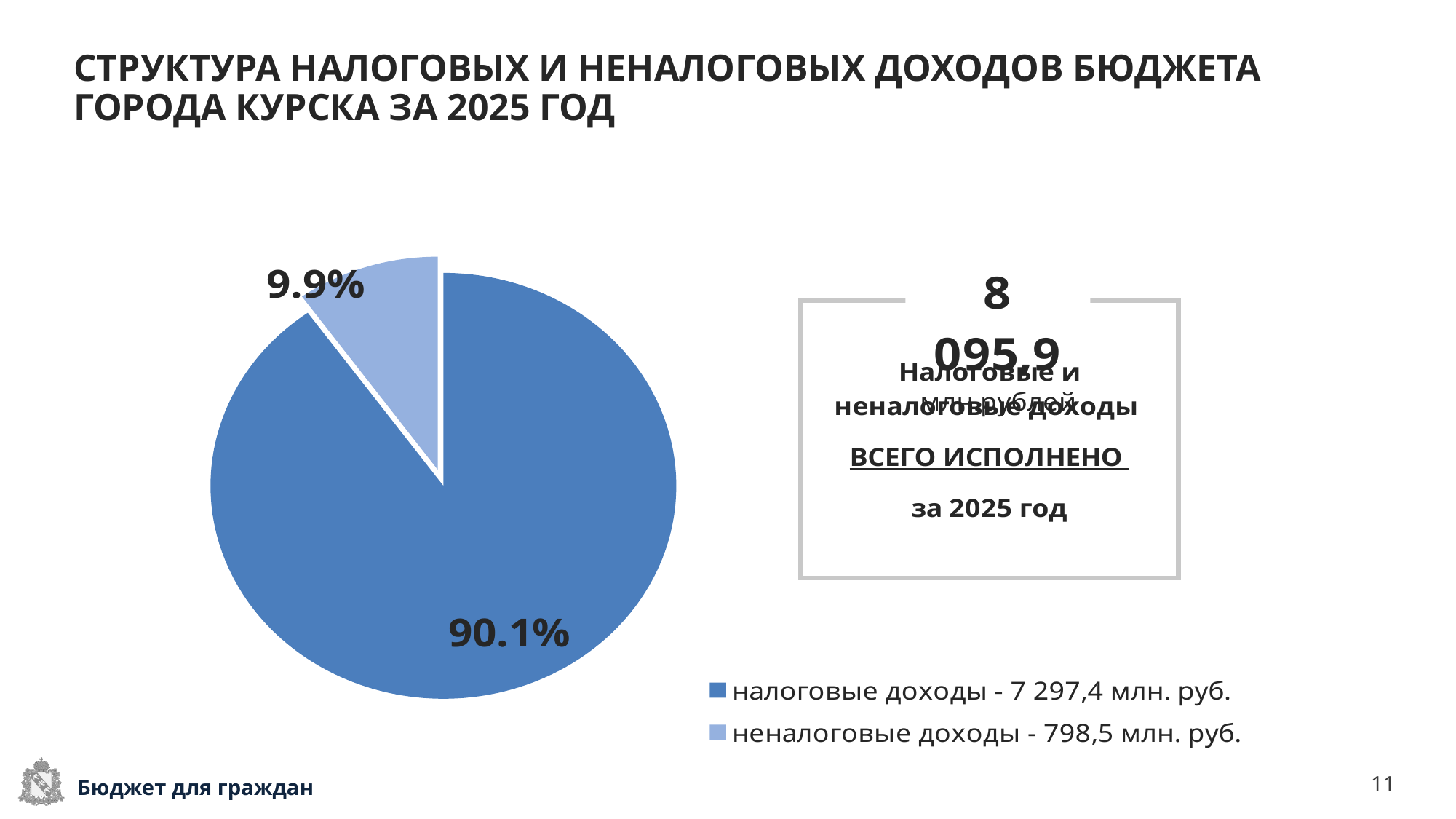
What is the difference in percentage points between the налоговые доходы slice and the неналоговые доходы slice? 80.2 Which is larger, налоговые доходы or неналоговые доходы? налоговые доходы According to the legend, what is the amount of налоговые доходы? 7 297,4 млн. руб. How many entries does the legend list? 2 According to the legend, what is the amount of неналоговые доходы? 798,5 млн. руб. What colour is the неналоговые доходы slice in the pie chart? light blue Which slice of the pie is the smallest? неналоговые доходы What share of the pie does неналоговые доходы take? 9.9% What kind of chart is shown on the slide? pie chart Which slice of the pie is the largest? налоговые доходы What share of the pie does налоговые доходы take? 90.1% How many slices does the pie chart have? 2